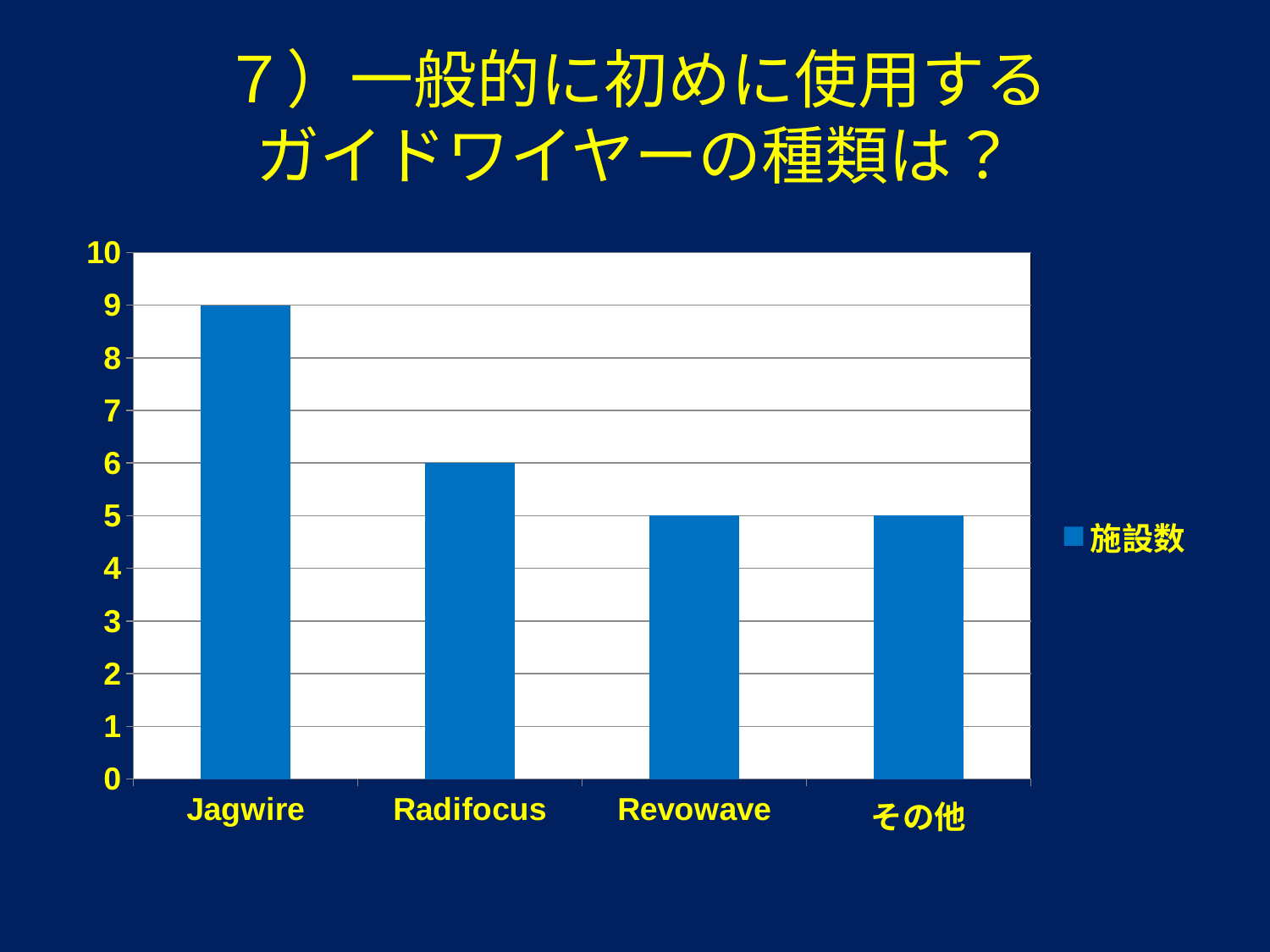
What is the value for Jagwire? 9 What kind of chart is shown on the slide? bar chart Is the value for Jagwire greater or less than 5? greater What is the value for その他? 5 Which category has the highest value? Jagwire How many categories are shown on the x axis? 4 What is the value for Revowave? 5 What is the difference between the values for Jagwire and Radifocus? 3 Which is larger, the value for Radifocus or the value for Revowave? Radifocus What is the value for Radifocus? 6 How many series does the legend list? 1 What is the legend entry for the series? 施設数